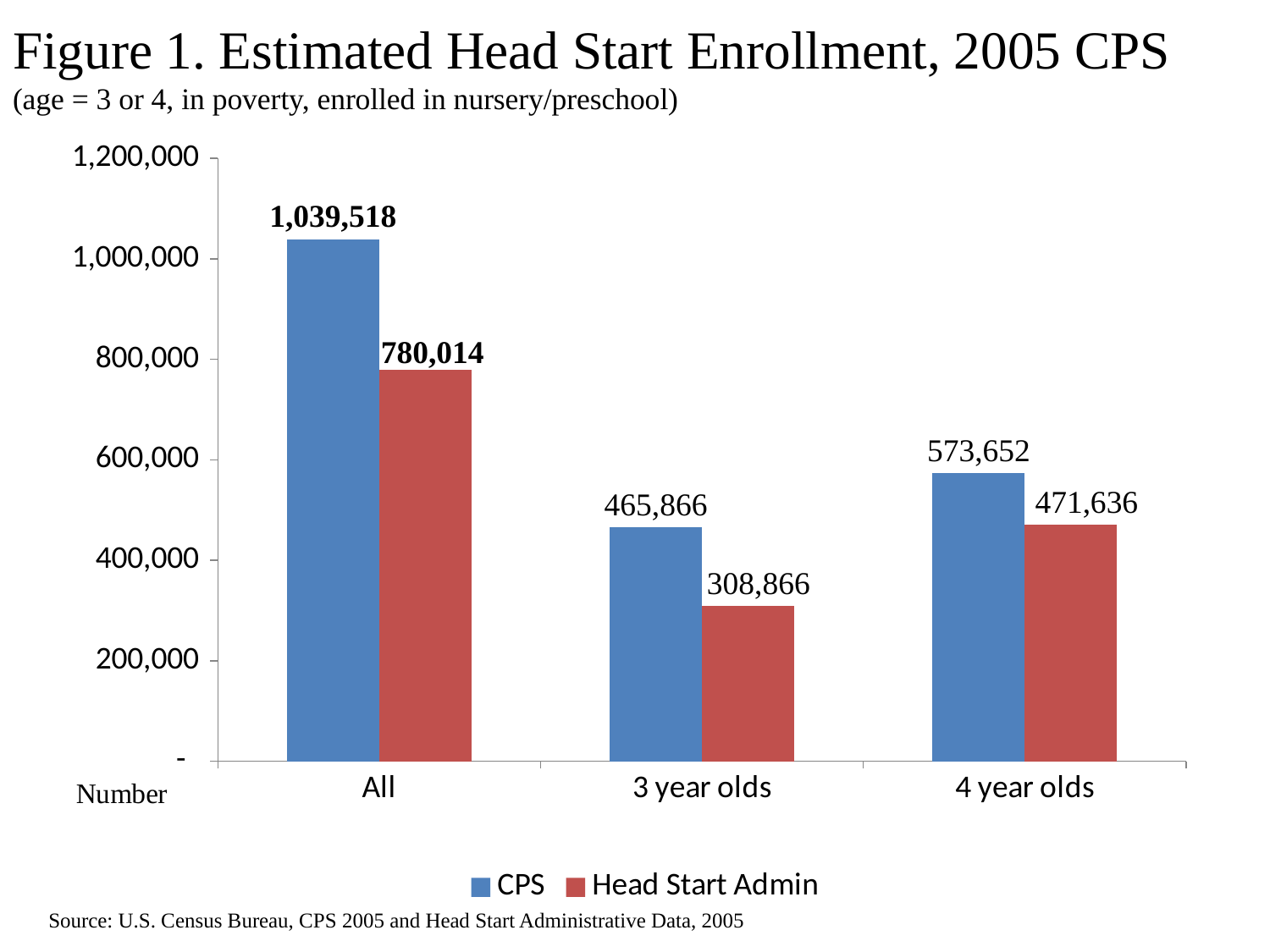
What is the Head Start Admin value for All? 780,014 What kind of chart is shown on the slide? Bar chart How many series does the legend list? 2 What is the CPS value for All? 1,039,518 What is the CPS value for 4 year olds? 573,652 Which category has the lowest Head Start Admin value? 3 year olds Which is larger for 4 year olds, the CPS value or the Head Start Admin value? CPS What is the difference between the CPS and Head Start Admin values for All? 259,504 Which category has the highest CPS value? All What is the difference between the CPS and Head Start Admin values for 3 year olds? 157,000 What is the Head Start Admin value for 3 year olds? 308,866 How many categories are shown on the x axis? 3